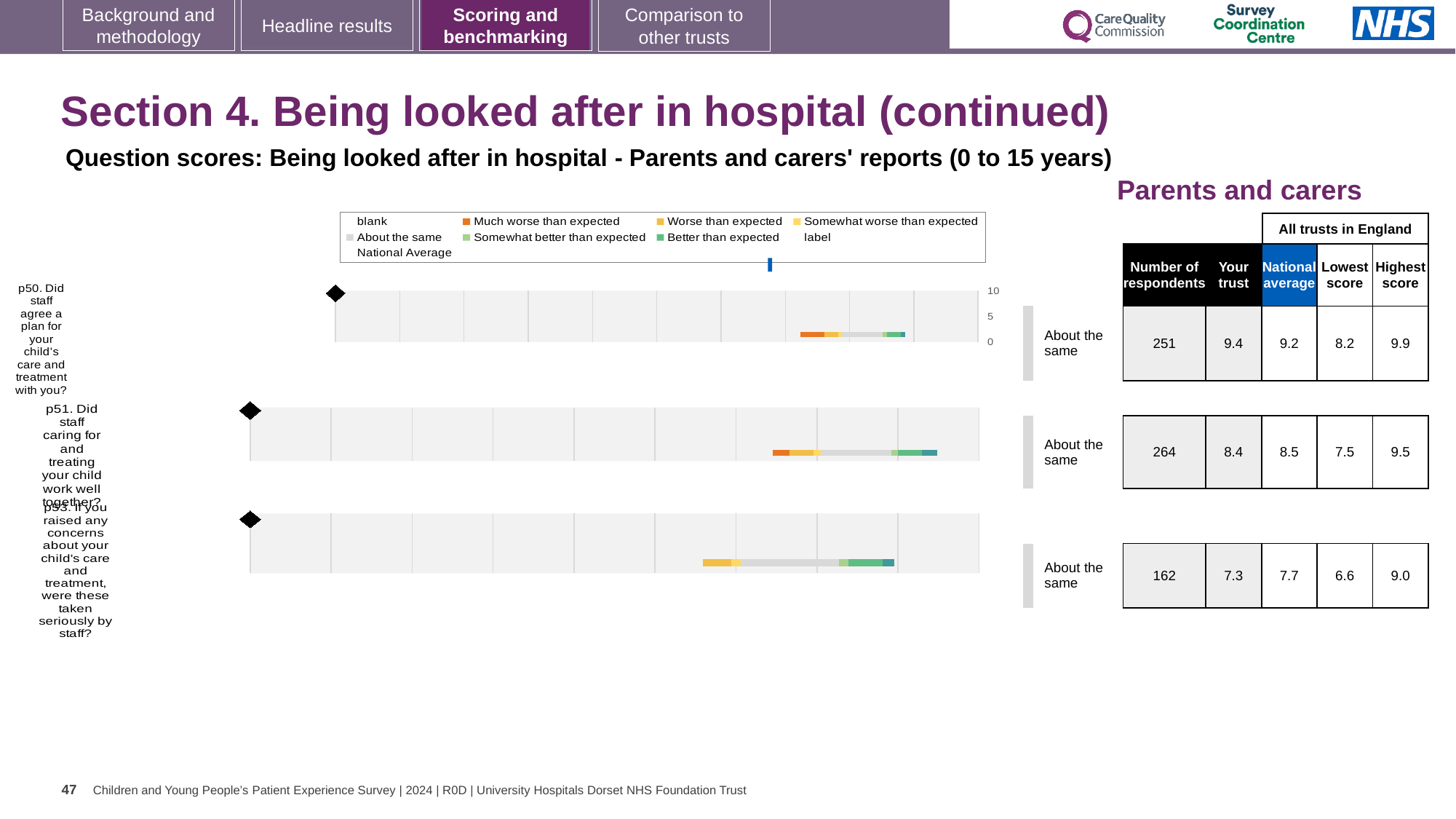
For p53 (If you raised any concerns about your child's care and treatment, were these taken seriously by staff?), how many respondents were there? 162 For p53, what is the difference between the national average and the 'Your trust' score? 0.4 For p53, what is the lowest score among all trusts in England? 6.6 For p50, is the 'Your trust' score or the national average higher? Your trust Which question has the highest 'Your trust' score? p50 Which question has the lowest 'Your trust' score? p53 What benchmark category is shown next to the chart for p51? About the same For p51, what is the difference between the highest score and the lowest score among all trusts in England? 2.0 What kind of chart is used to show the question scores on this slide? bar chart For p50 (Did staff agree a plan for your child's care and treatment with you?), what is the 'Your trust' score? 9.4 For p51 (Did staff caring for and treating your child work well together?), what is the national average score? 8.5 How many questions (charts) are shown on the slide? 3